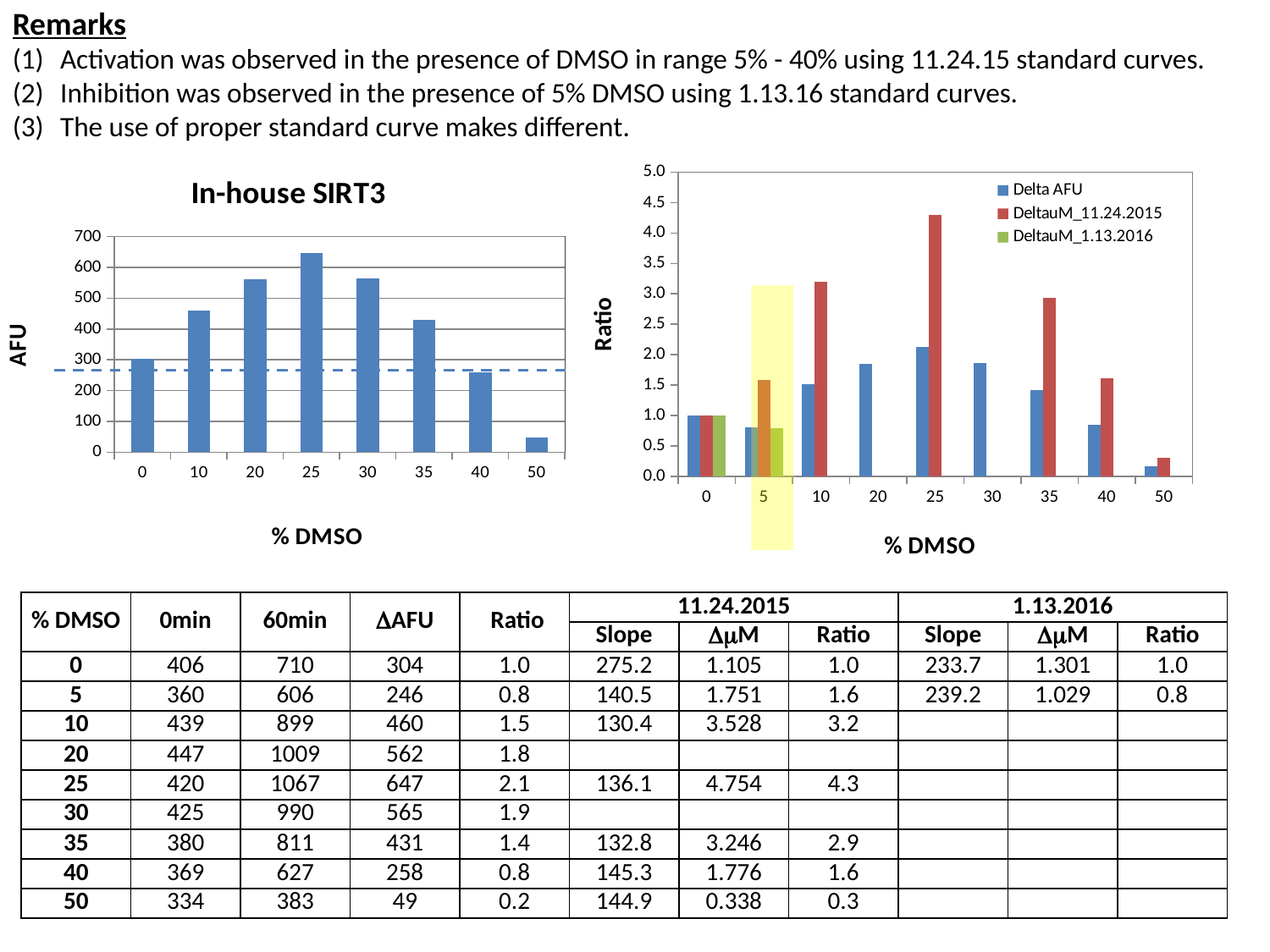
How many % DMSO categories are shown on the In-house SIRT3 chart? 8 On the In-house SIRT3 chart, is the AFU value for 10% DMSO greater or less than 400? greater On the In-house SIRT3 chart, which has the higher AFU: 20% DMSO or 40% DMSO? 20 How many series does the legend of the right-hand Ratio chart list? 3 How many % DMSO categories are shown on the right-hand Ratio chart? 9 On the right-hand Ratio chart, is the DeltauM_11.24.2015 value for 25% DMSO greater or less than 4.0? greater On the In-house SIRT3 chart, which % DMSO category has the highest AFU? 25 On the In-house SIRT3 chart, is the AFU value for 50% DMSO greater or less than 100? less On the right-hand Ratio chart, which % DMSO category has the highest DeltauM_11.24.2015 ratio? 25 On the right-hand Ratio chart, which % DMSO category is highlighted in yellow? 5 What type of chart is the In-house SIRT3 chart? bar chart On the In-house SIRT3 chart, which % DMSO category has the lowest AFU? 50